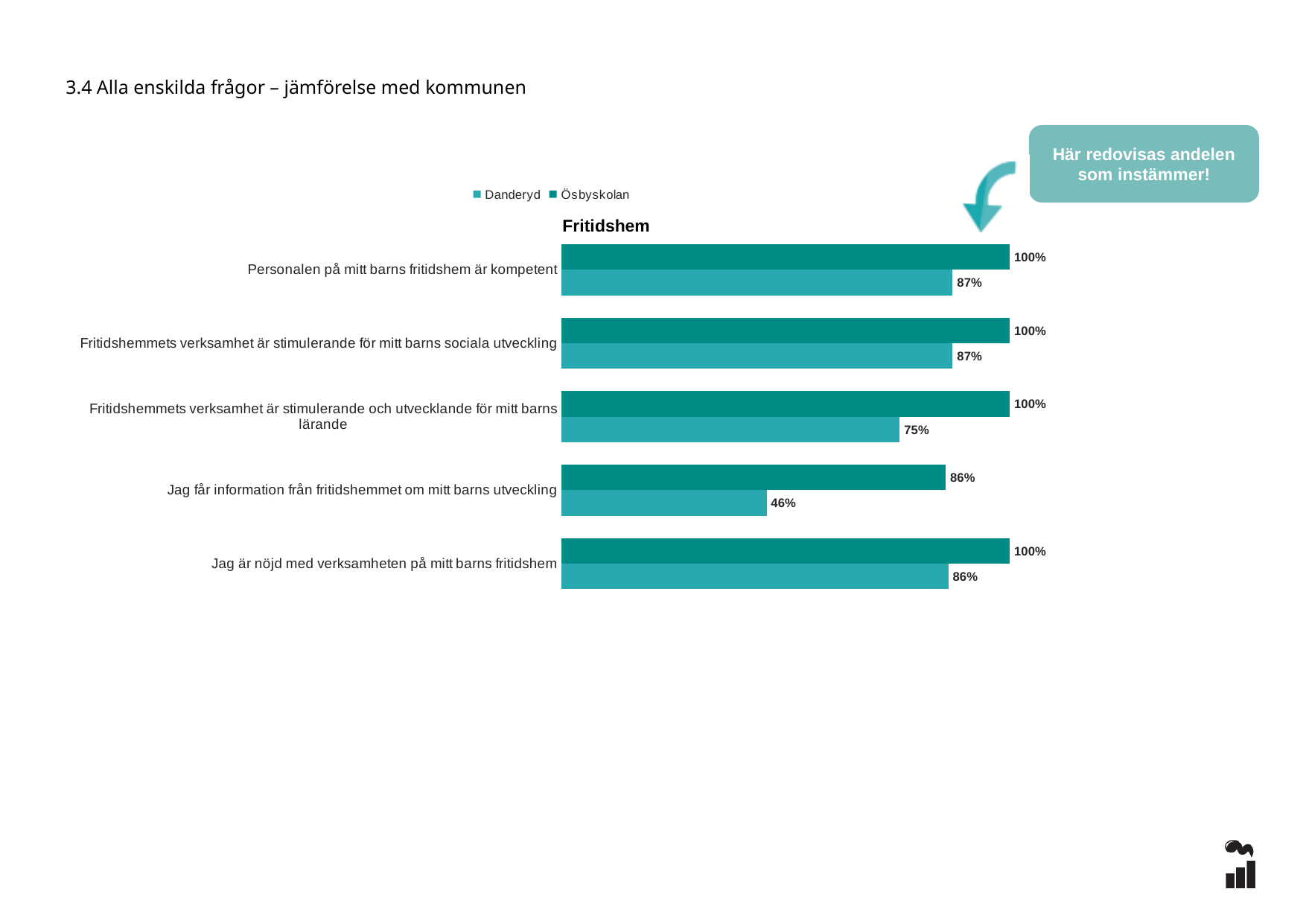
What is the value for Danderyd on "Fritidshemmets verksamhet är stimulerande och utvecklande för mitt barns lärande"? 75% What is the value for Danderyd on "Personalen på mitt barns fritidshem är kompetent"? 87% How many series does the legend list? 2 What type of chart is shown on the slide? bar chart What is the title shown above the bars in the chart? Fritidshem What is the difference between Ösbyskolan and Danderyd on "Jag får information från fritidshemmet om mitt barns utveckling"? 40 percentage points How many statements (categories) are shown in the chart? 5 Which is larger on "Jag är nöjd med verksamheten på mitt barns fritidshem": Danderyd or Ösbyskolan? Ösbyskolan What is the value for Ösbyskolan on "Jag får information från fritidshemmet om mitt barns utveckling"? 86% What is the value for Danderyd on "Jag får information från fritidshemmet om mitt barns utveckling"? 46% Which statement has the lowest value for Danderyd? Jag får information från fritidshemmet om mitt barns utveckling What is the value for Ösbyskolan on "Personalen på mitt barns fritidshem är kompetent"? 100%